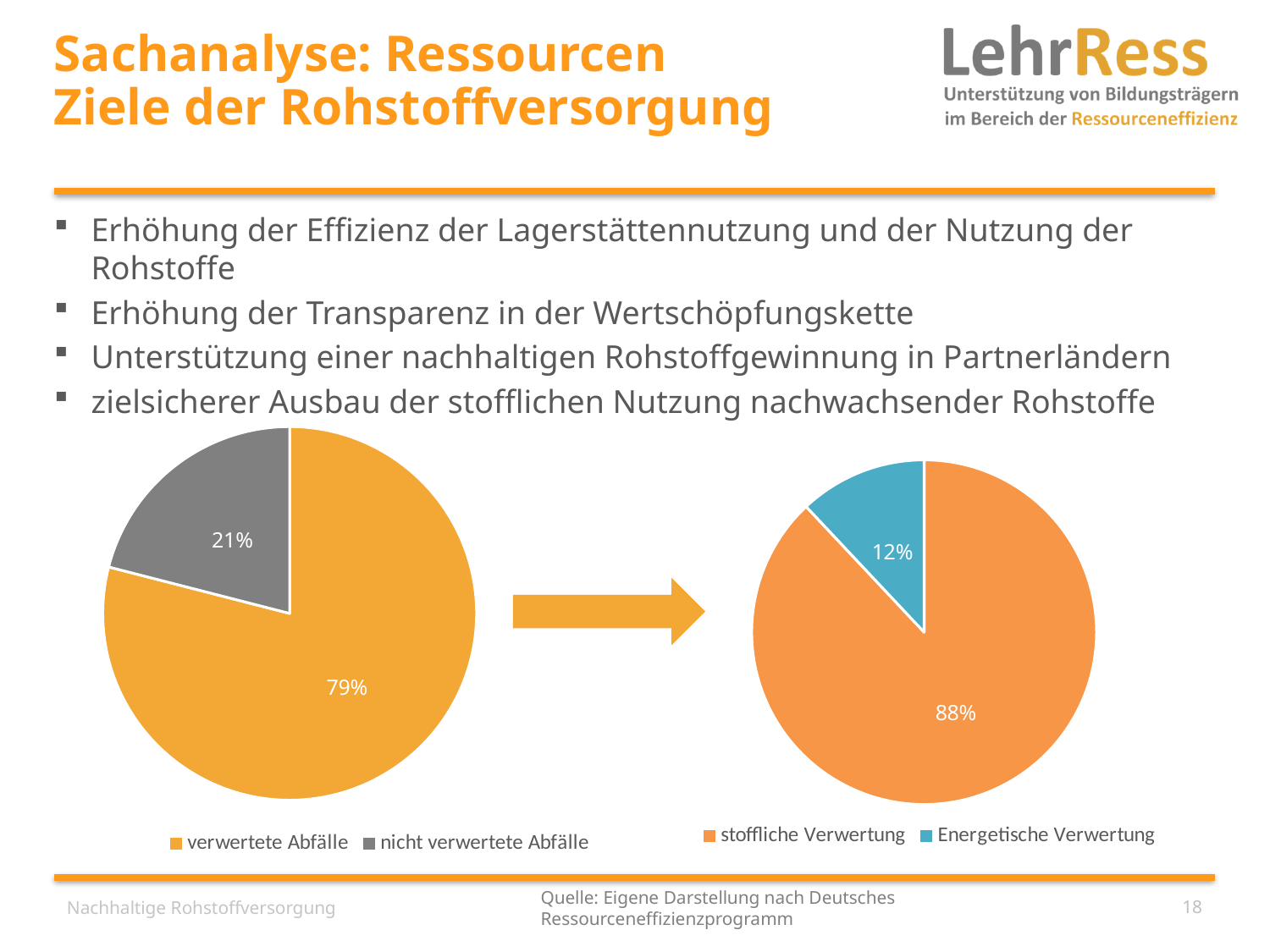
In the right pie chart, what share is labelled for stoffliche Verwertung? 88% In the left pie chart, what share is labelled for verwertete Abfälle? 79% Which is larger: the share of nicht verwertete Abfälle in the left pie chart or the share of Energetische Verwertung in the right pie chart? nicht verwertete Abfälle In the left pie chart, what share is labelled for nicht verwertete Abfälle? 21% In the right pie chart, what colour is the slice for Energetische Verwertung? Blue In the right pie chart, what is the difference in percentage points between stoffliche Verwertung and Energetische Verwertung? 76 In the left pie chart, which slice is the largest? verwertete Abfälle In the right pie chart, what share is labelled for Energetische Verwertung? 12% What type of chart is the right chart on the slide? Pie chart How many slices does the left pie chart have? 2 In the right pie chart, which slice is the smallest? Energetische Verwertung In the left pie chart, what is the difference in percentage points between verwertete Abfälle and nicht verwertete Abfälle? 58